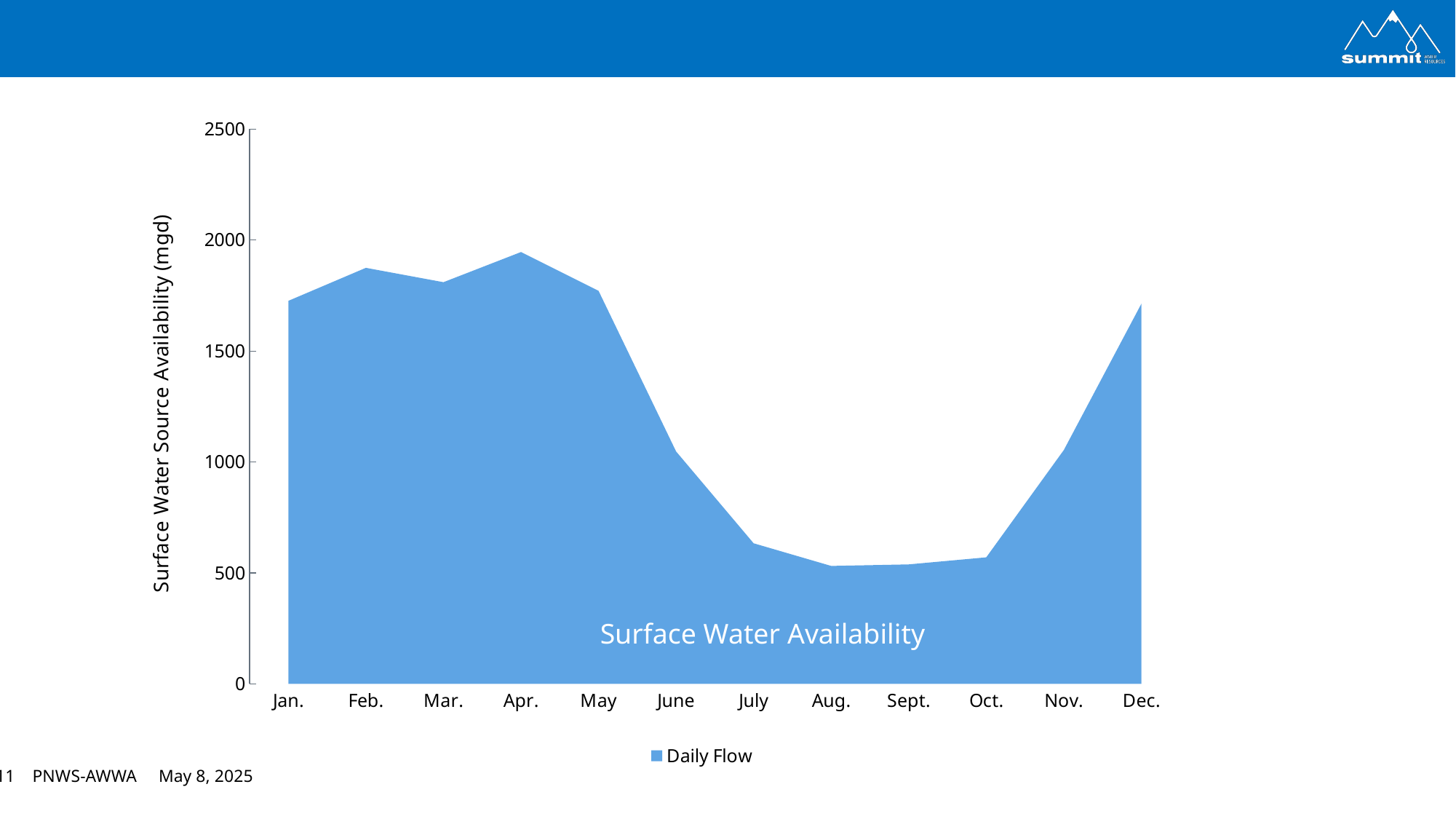
How many months are plotted along the x axis? 12 Which month has the highest surface water availability? Apr. How many series does the legend list? 1 What is the name of the series shown in the legend? Daily Flow Is the value for Apr. greater or less than 1500? greater Is the value for June greater or less than 1500? less Which is larger, the value for July or the value for Nov.? Nov. What kind of chart is shown on the slide? area chart What is the label on the vertical axis? Surface Water Source Availability (mgd) Do the values rise or fall from Apr. to Aug.? fall Is the value for Aug. greater or less than 1000? less Which is larger, the value for Jan. or the value for June? Jan.